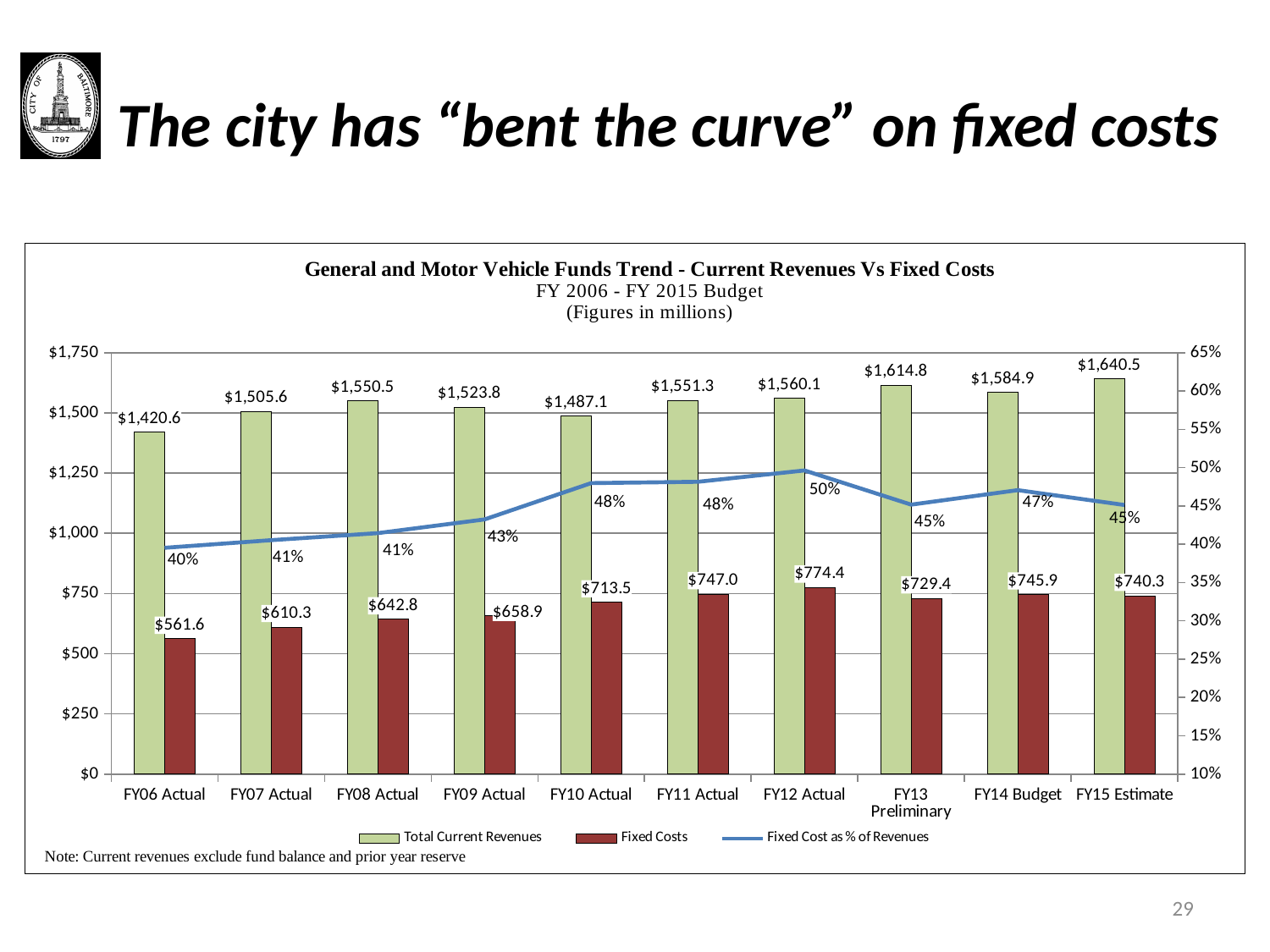
Which fiscal year has the lowest Total Current Revenues? FY06 Actual How many fiscal years are shown on the x axis? 10 Which is larger, Fixed Costs for FY13 Preliminary or for FY14 Budget? FY14 Budget Which fiscal year has the highest Fixed Costs? FY12 Actual In which fiscal year does Fixed Cost as % of Revenues reach its highest value? FY12 Actual What is the Fixed Cost as % of Revenues for FY09 Actual? 43% By how much did Fixed Costs increase from FY06 Actual to FY15 Estimate? $178.7 What is the Fixed Costs value for FY10 Actual? $713.5 What is the title of the chart? General and Motor Vehicle Funds Trend - Current Revenues Vs Fixed Costs What is the difference between Total Current Revenues and Fixed Costs for FY12 Actual? $785.7 How many series does the legend list? 3 What is the Total Current Revenues value for FY15 Estimate? $1,640.5